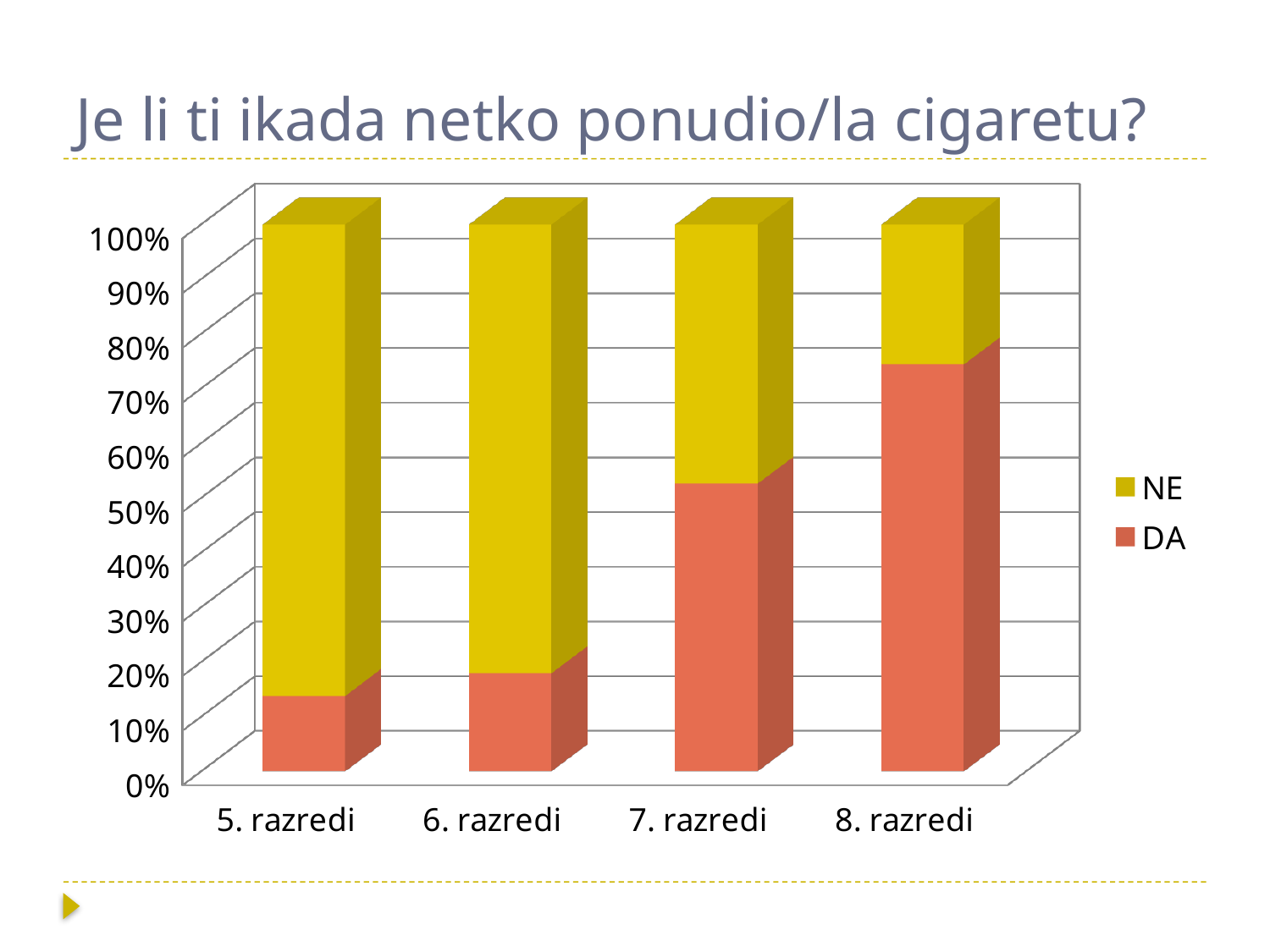
Does the DA share rise or fall from 5. razredi to 8. razredi? rise Which category has the smallest DA share? 5. razredi Is the DA value for 8. razredi greater or less than 70%? greater What kind of chart is shown on the slide? bar chart How many series does the legend list? 2 Is the DA value for 5. razredi greater or less than 20%? less Is the DA value for 7. razredi greater or less than 50%? greater How many categories are shown on the x axis? 4 What is the title of the chart? Je li ti ikada netko ponudio/la cigaretu? Which is larger, the DA share for 7. razredi or for 8. razredi? 8. razredi Which category has the largest NE share? 5. razredi Which category has the largest DA share? 8. razredi